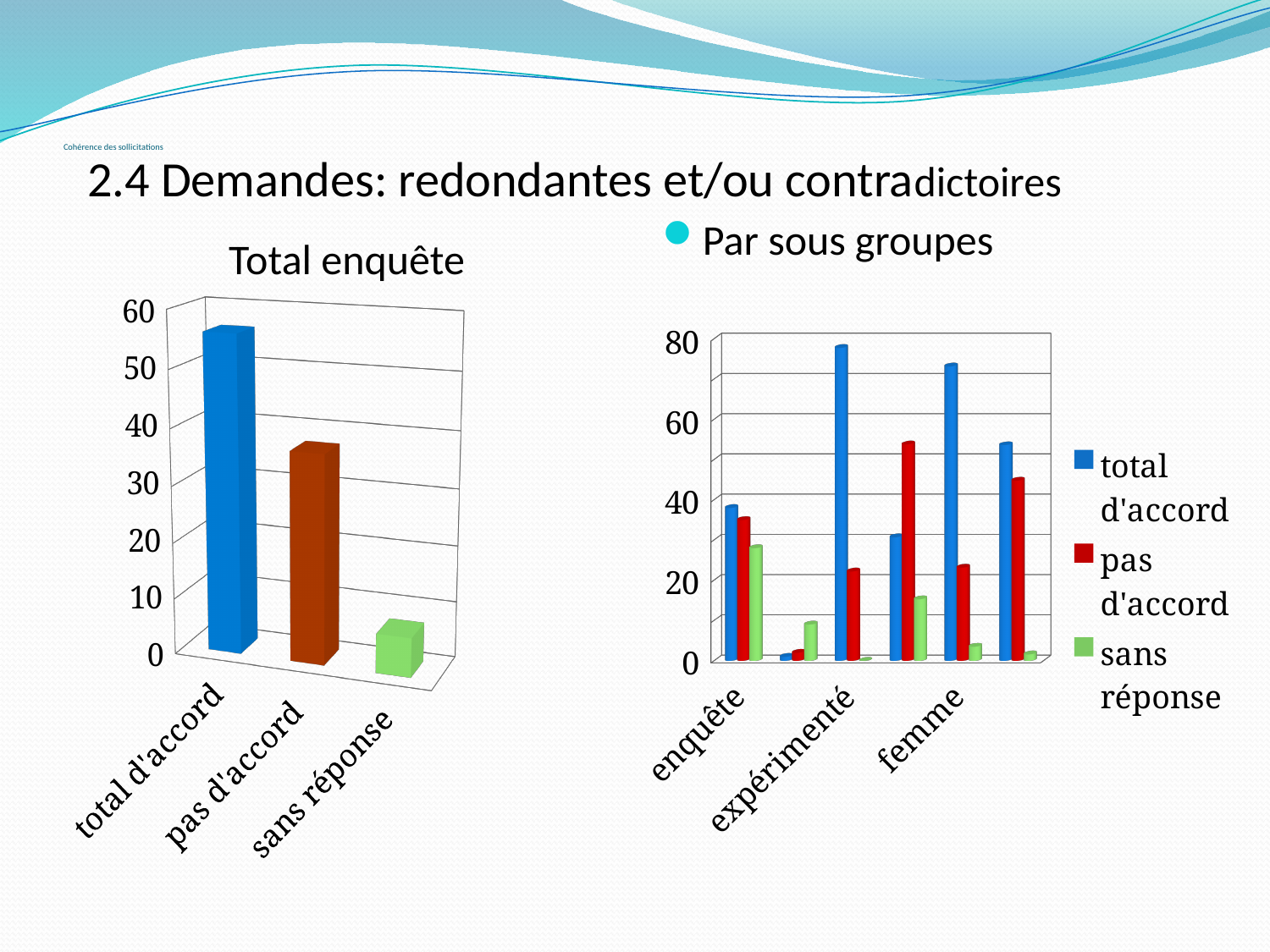
How many series does the legend of the 'Par sous groupes' chart list? 3 What kind of chart is the 'Total enquête' chart? bar chart In the 'Total enquête' chart, is the value for 'sans réponse' greater or less than 10? less In the 'Par sous groupes' chart, for 'enquête', which is larger: 'total d'accord' or 'sans réponse'? total d'accord In the 'Par sous groupes' chart, for 'femme', which series has the highest value? total d'accord In the 'Par sous groupes' chart, is the 'total d'accord' value for 'expérimenté' greater or less than 60? greater How many categories are shown in the 'Total enquête' chart? 3 In the 'Total enquête' chart, is the value for 'total d'accord' greater or less than 50? greater In the 'Par sous groupes' chart, which colour represents the 'pas d'accord' series? red In the 'Total enquête' chart, which category has the lowest value? sans réponse In the 'Total enquête' chart, which category has the highest value? total d'accord